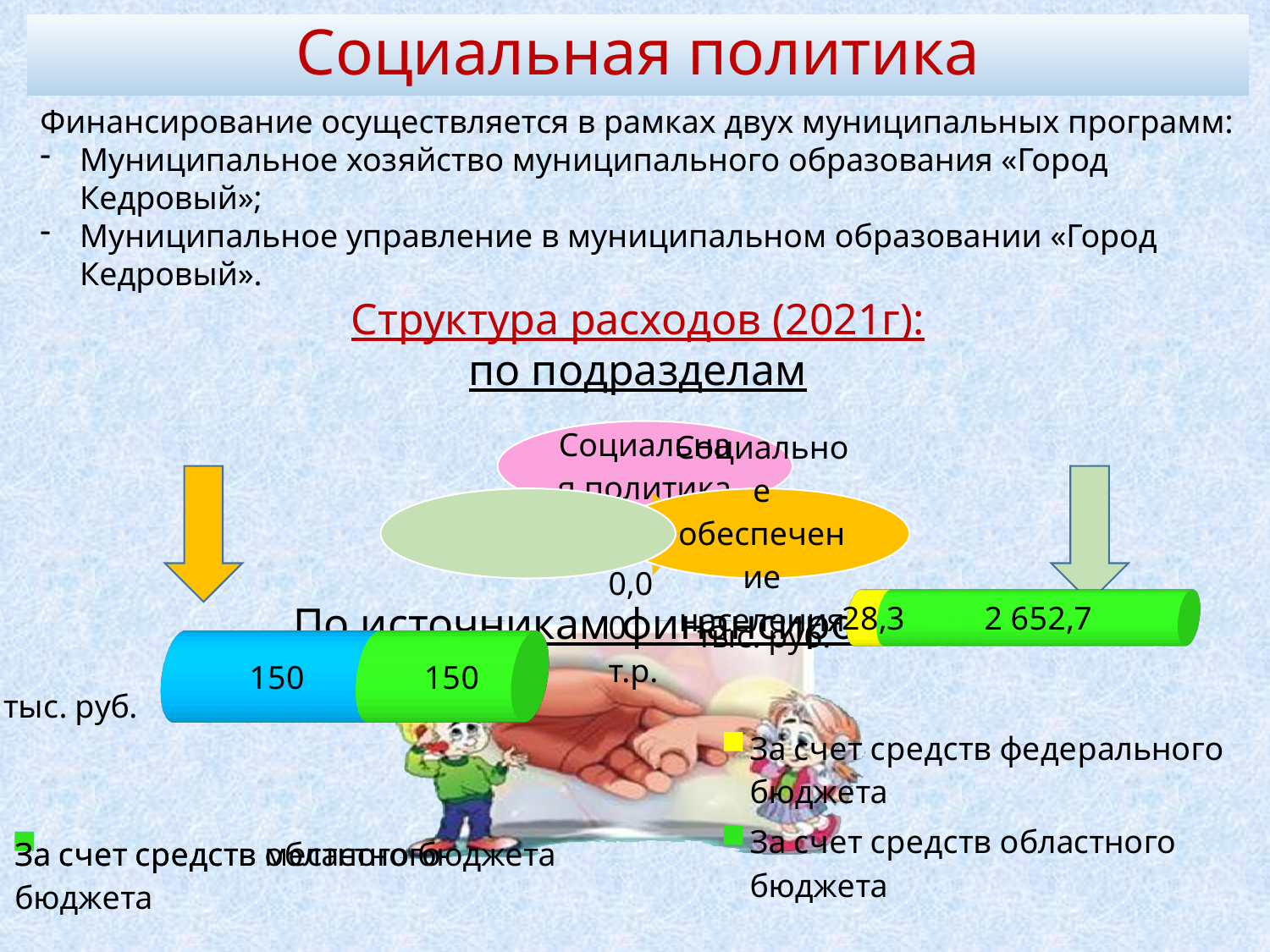
How many series does the legend of the bar chart on the right of the slide list? 2 In the bar chart on the left of the slide, what is the total of the stacked bar? 300 In the bar chart on the right of the slide, what colour is the segment for За счет средств федерального бюджета? yellow In the bar chart on the right of the slide, which source is larger: федерального бюджета or областного бюджета? За счет средств областного бюджета In the bar chart on the left of the slide, what value is printed on the blue segment? 150 What unit is shown next to the bar chart on the left of the slide? тыс. руб. In the bar chart on the right of the slide (По источникам финансирования), what is the value for За счет средств областного бюджета? 2 652,7 What kind of chart is shown at the bottom right of the slide under По источникам финансирования? bar chart In the bar chart on the left of the slide, what value is printed on the green segment? 150